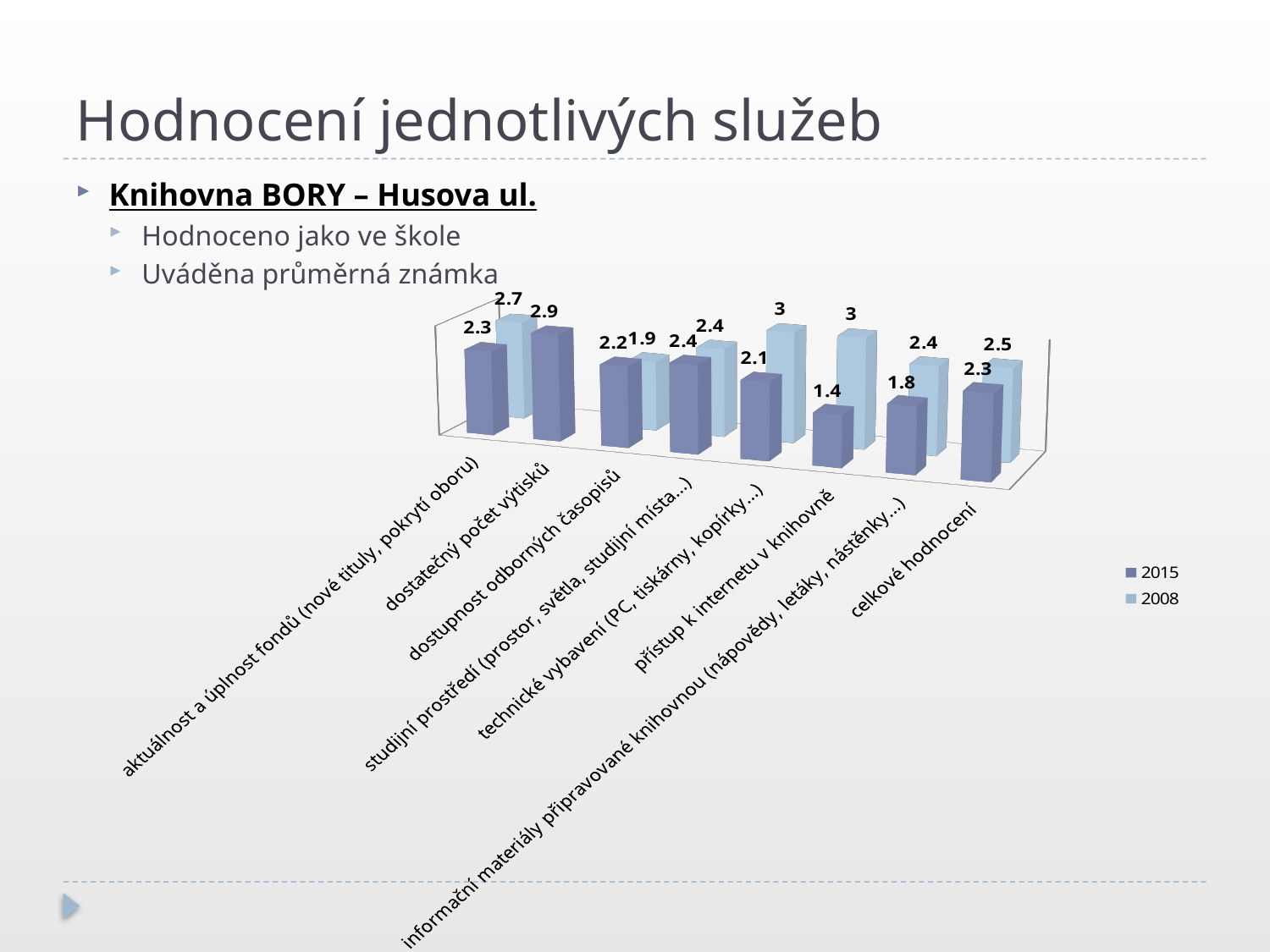
What is the 2015 value for 'celkové hodnocení'? 2.3 Which category has the lowest 2015 value? přístup k internetu v knihovně What is the difference between the 2008 and 2015 values for 'přístup k internetu v knihovně'? 1.6 What is the 2008 value for 'dostupnost odborných časopisů'? 1.9 What kind of chart is shown on the slide? bar chart How many series does the legend list? 2 What is the 2015 value for 'technické vybavení (PC, tiskárny, kopírky...)'? 2.1 For 'technické vybavení (PC, tiskárny, kopírky...)', which series has the larger value, 2015 or 2008? 2008 What is the 2008 value for 'přístup k internetu v knihovně'? 3 What is the 2015 value for 'informační materiály připravované knihovnou (nápovědy, letáky, nástěnky...)'? 1.8 How many categories are shown on the chart? 8 Which category has the highest 2015 value? dostatečný počet výtisků